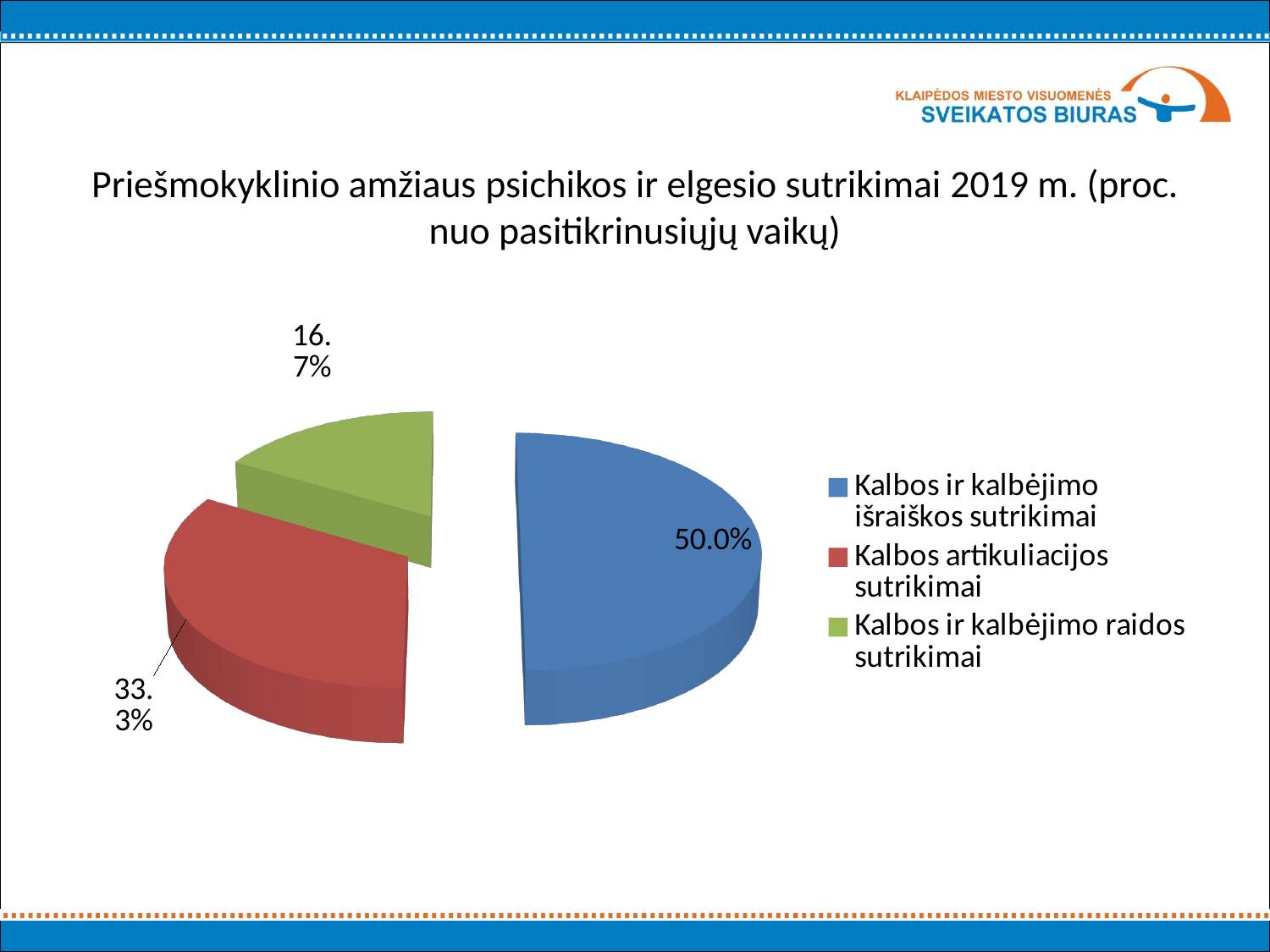
What is the difference in percentage points between "Kalbos ir kalbėjimo išraiškos sutrikimai" and "Kalbos artikuliacijos sutrikimai"? 16.7 Which category has the smallest slice of the pie? Kalbos ir kalbėjimo raidos sutrikimai What share of the pie does "Kalbos ir kalbėjimo raidos sutrikimai" have? 16.7% How many entries does the legend list? 3 What share of the pie does "Kalbos artikuliacijos sutrikimai" have? 33.3% Which category has the largest slice of the pie? Kalbos ir kalbėjimo išraiškos sutrikimai What kind of chart is shown on the slide? pie chart What colour is the slice for "Kalbos artikuliacijos sutrikimai"? red Which is larger: the slice for "Kalbos artikuliacijos sutrikimai" or the slice for "Kalbos ir kalbėjimo raidos sutrikimai"? Kalbos artikuliacijos sutrikimai How many slices does the pie chart have? 3 What share of the pie does "Kalbos ir kalbėjimo išraiškos sutrikimai" have? 50.0% What year does the chart title refer to? 2019